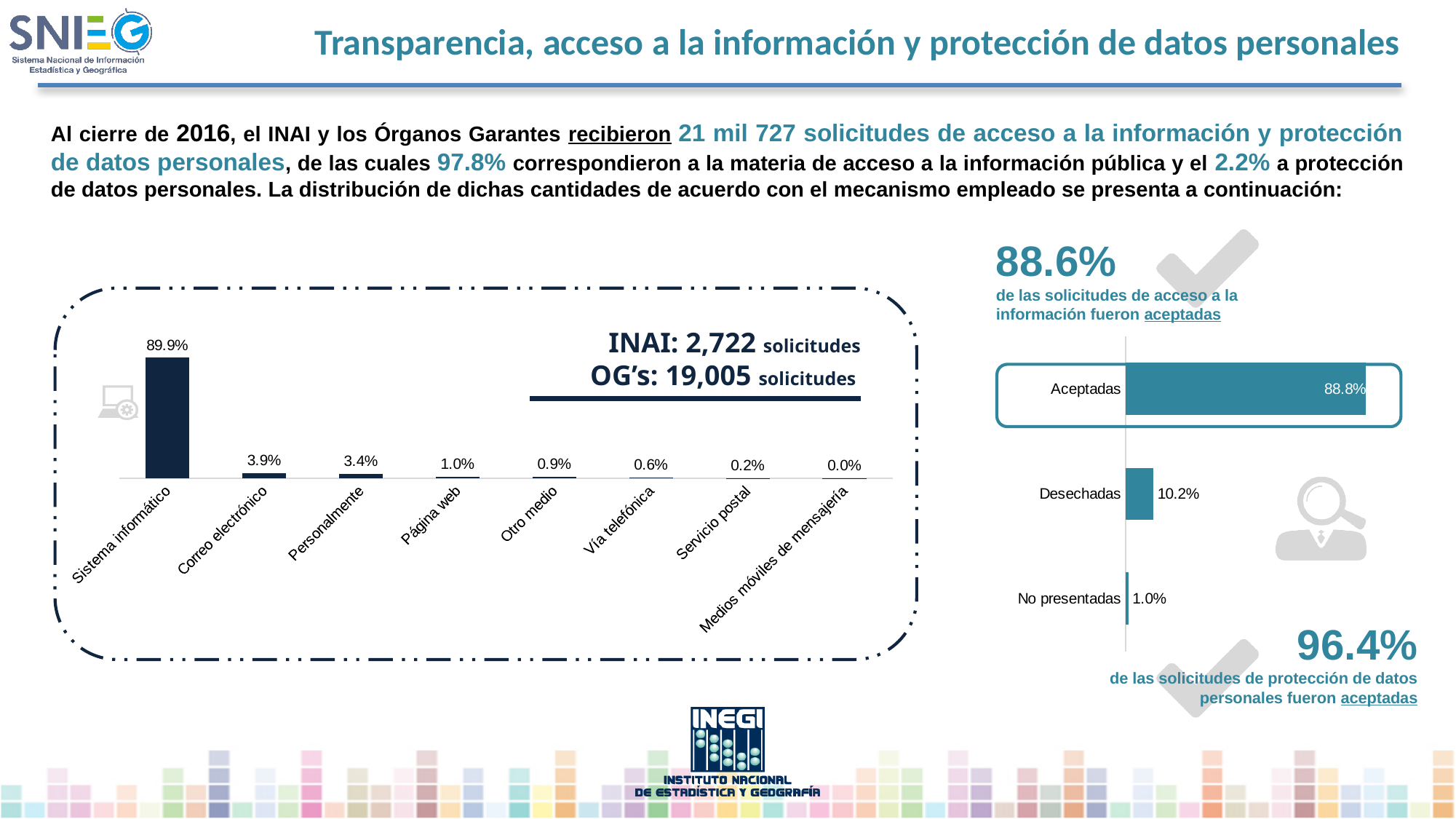
What kind of chart is the left chart? Bar chart In the left chart, what is the value for Sistema informático? 89.9% In the left chart, what is the value for Correo electrónico? 3.9% In the left chart, which category has the highest value? Sistema informático In the left chart, how many categories are shown? 8 In the right chart, what is the value for No presentadas? 1.0% In the right chart, which category has the highest value? Aceptadas In the left chart, which category has the lowest value? Medios móviles de mensajería In the left chart, what is the difference between Correo electrónico and Personalmente? 0.5% In the left chart, what is the value for Vía telefónica? 0.6% In the right chart, what is the value for Desechadas? 10.2% In the right chart, what is the difference between Aceptadas and Desechadas? 78.6%